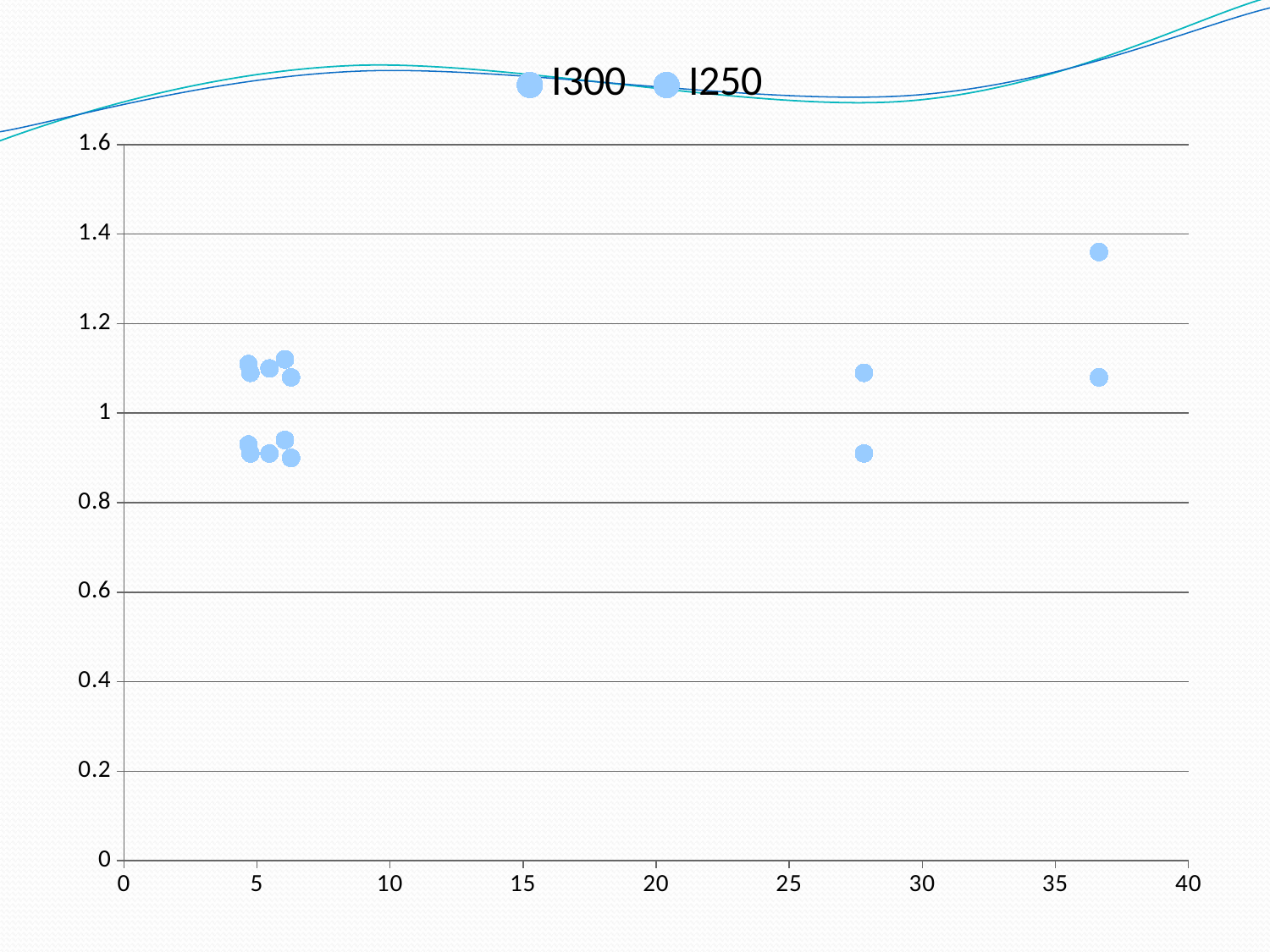
How many series does the legend list? 2 Is the highest plotted point (near x = 37) greater or less than 1.2? greater Is the upper point near x = 28 greater or less than 1? greater What are the two series names shown in the legend? I300 and I250 What is the maximum value shown on the vertical axis? 1.6 Are the lower cluster of points near x = 5 greater or less than 0.8? greater Which is larger: the upper point near x = 37 or the upper point near x = 28? the upper point near x = 37 What kind of chart is shown on the slide? scatter chart